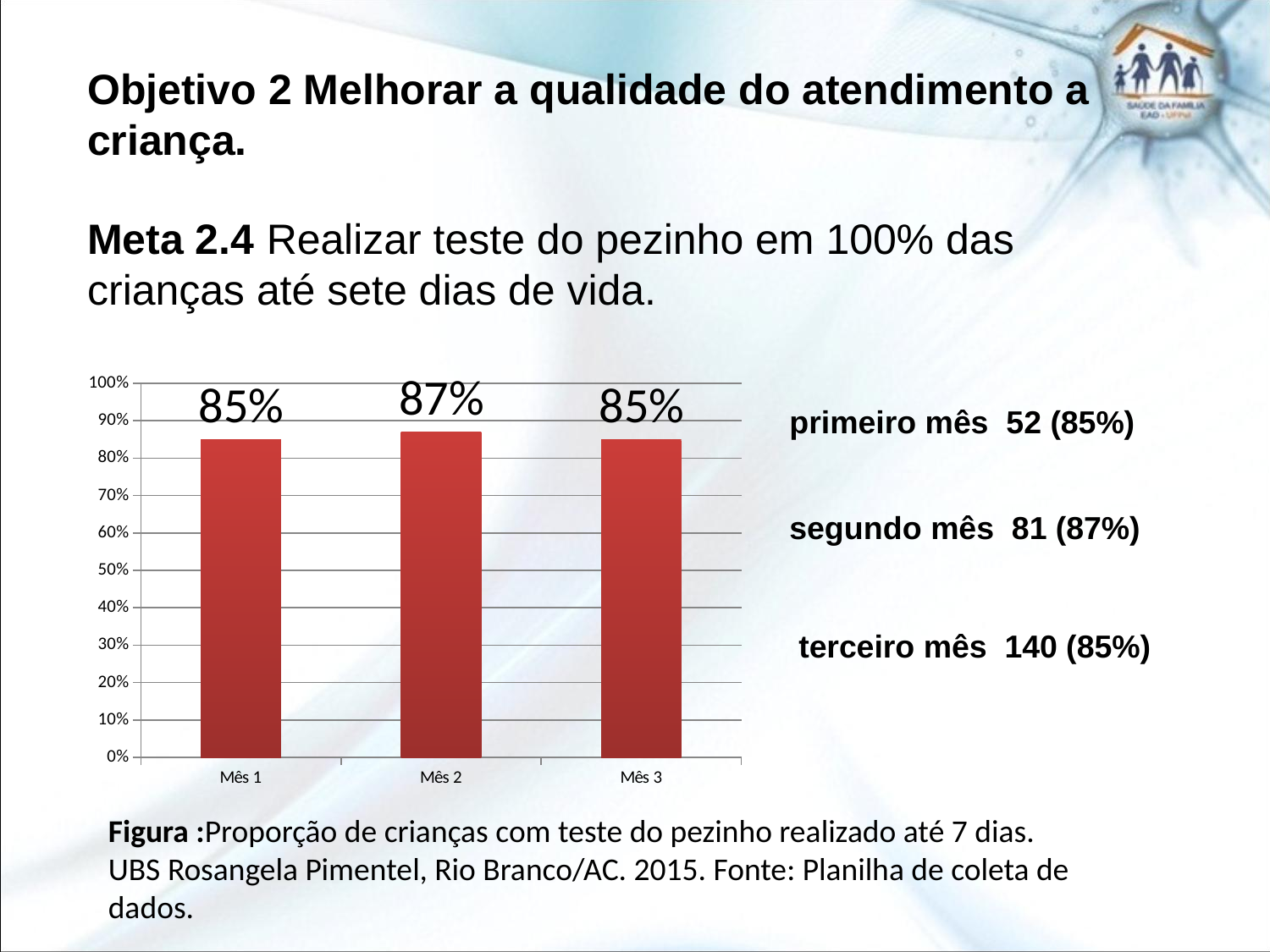
What is the value for Mês 2? 87% Is the value for Mês 2 greater or less than 90%? less What kind of chart is shown? bar chart What colour are the bars in the chart? red What is the value for Mês 3? 85% How many months are shown on the x axis? 3 What is the maximum value shown on the y axis? 100% What is the value for Mês 1? 85% Which month has the highest value? Mês 2 Which is larger, the value for Mês 2 or the value for Mês 3? Mês 2 Is the value for Mês 1 greater or less than 80%? greater What is the difference between the values for Mês 2 and Mês 1? 2%